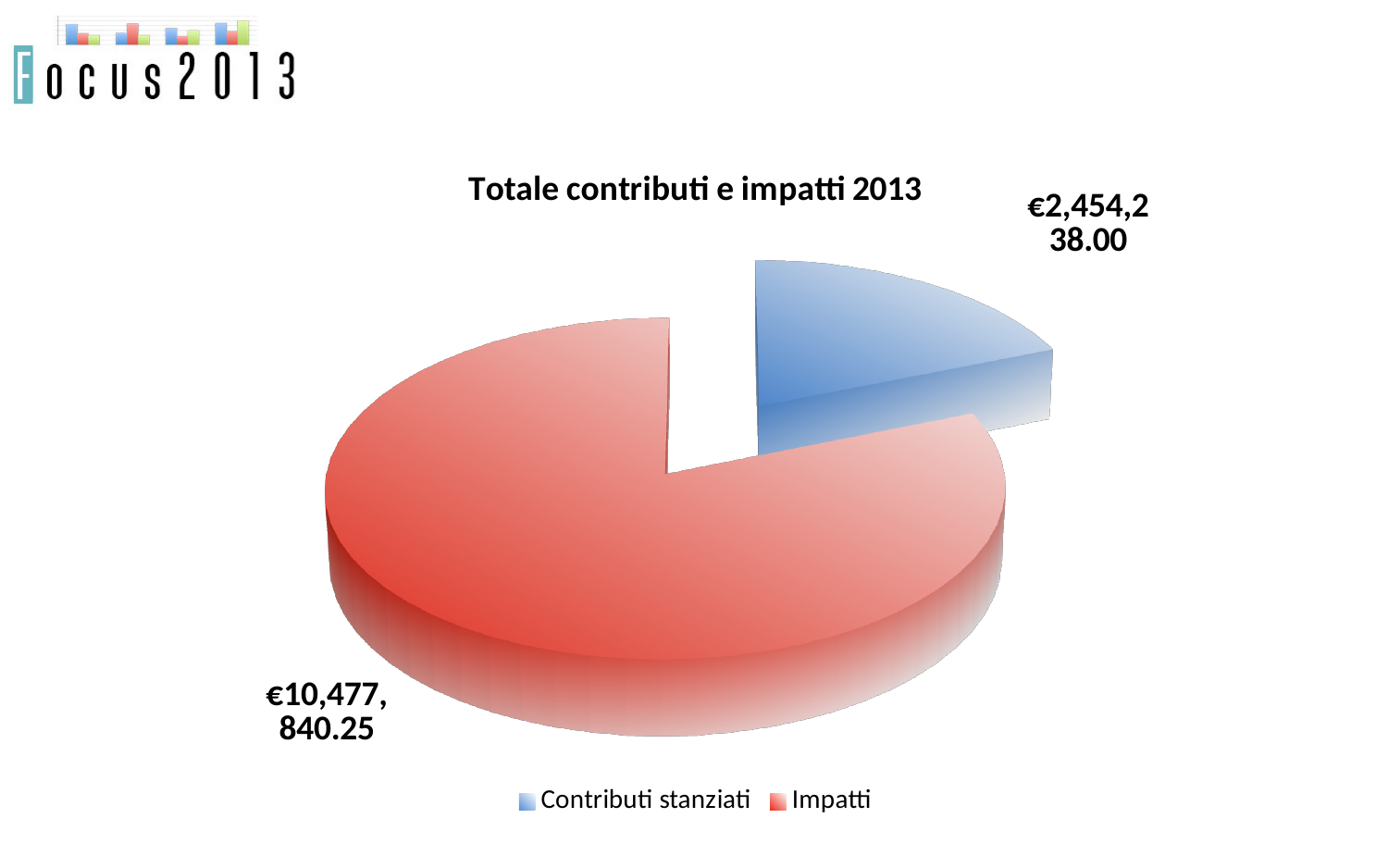
Which slice is the smallest in the pie chart? Contributi stanziati What is the difference between the Impatti value and the Contributi stanziati value? €8,023,602.25 Which slice is the largest in the pie chart? Impatti What kind of chart is shown on the slide? Pie chart What colour is the Impatti slice? Red How many entries does the legend list? 2 What is the title of the chart? Totale contributi e impatti 2013 What is the total of the two slices in the pie chart? €12,932,078.25 What is the value of the Impatti slice? €10,477,840.25 How many slices does the pie chart have? 2 What is the value of the Contributi stanziati slice? €2,454,238.00 Which is larger, Contributi stanziati or Impatti? Impatti